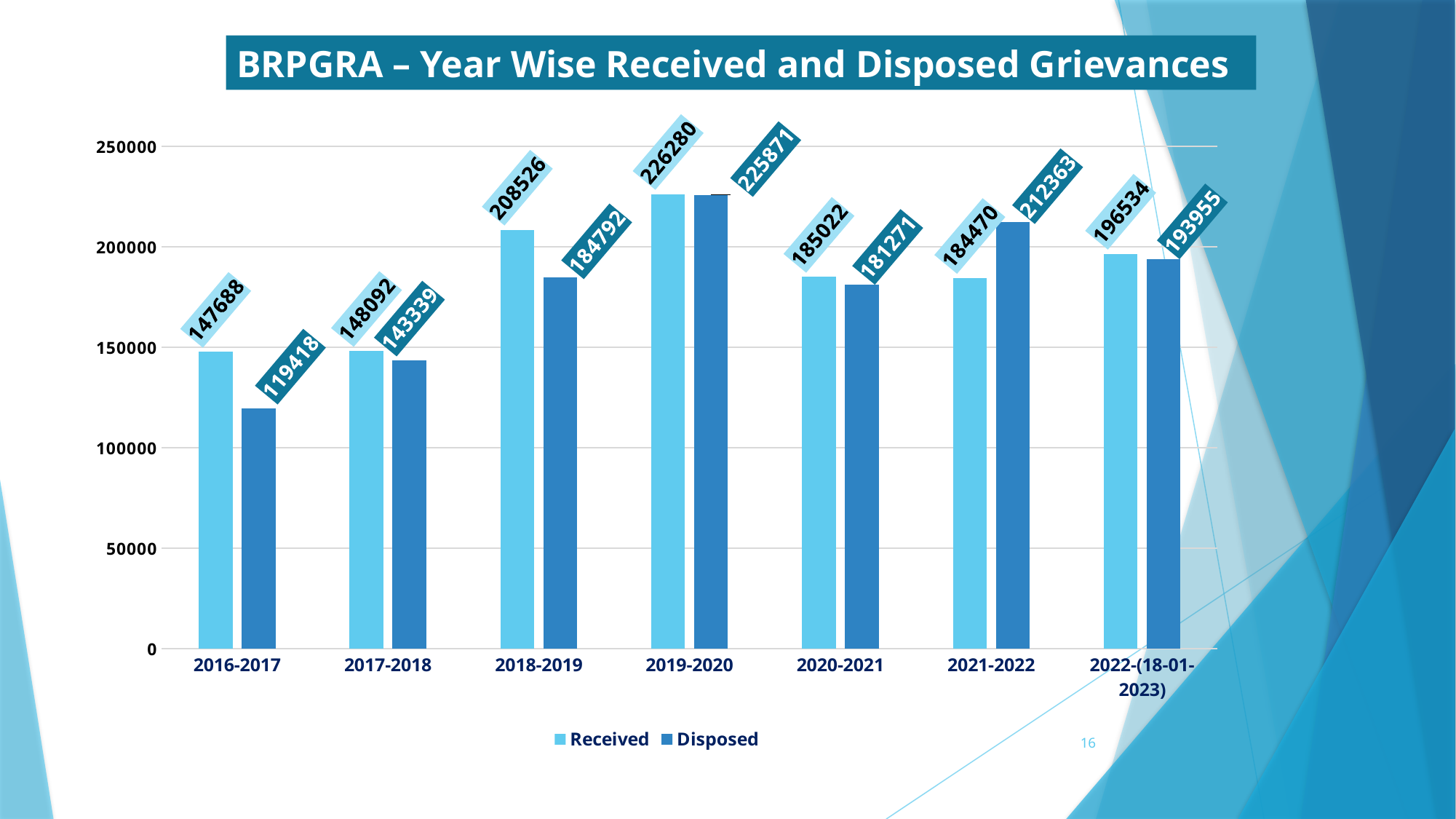
Which year has the lowest number of grievances disposed? 2016-2017 What is the number of grievances disposed in 2019-2020? 225871 Which year has the highest number of grievances received? 2019-2020 What kind of chart is shown on the slide? Bar chart How many series does the legend list? 2 How many year categories are shown on the x axis? 7 What is the number of grievances disposed in 2022-(18-01-2023)? 193955 What is the difference between grievances received and disposed in 2016-2017? 28270 Is the number of grievances disposed in 2017-2018 greater or less than 150000? less Which is larger in 2021-2022, the number received or the number disposed? Disposed What is the number of grievances received in 2016-2017? 147688 What is the title of the chart? BRPGRA – Year Wise Received and Disposed Grievances